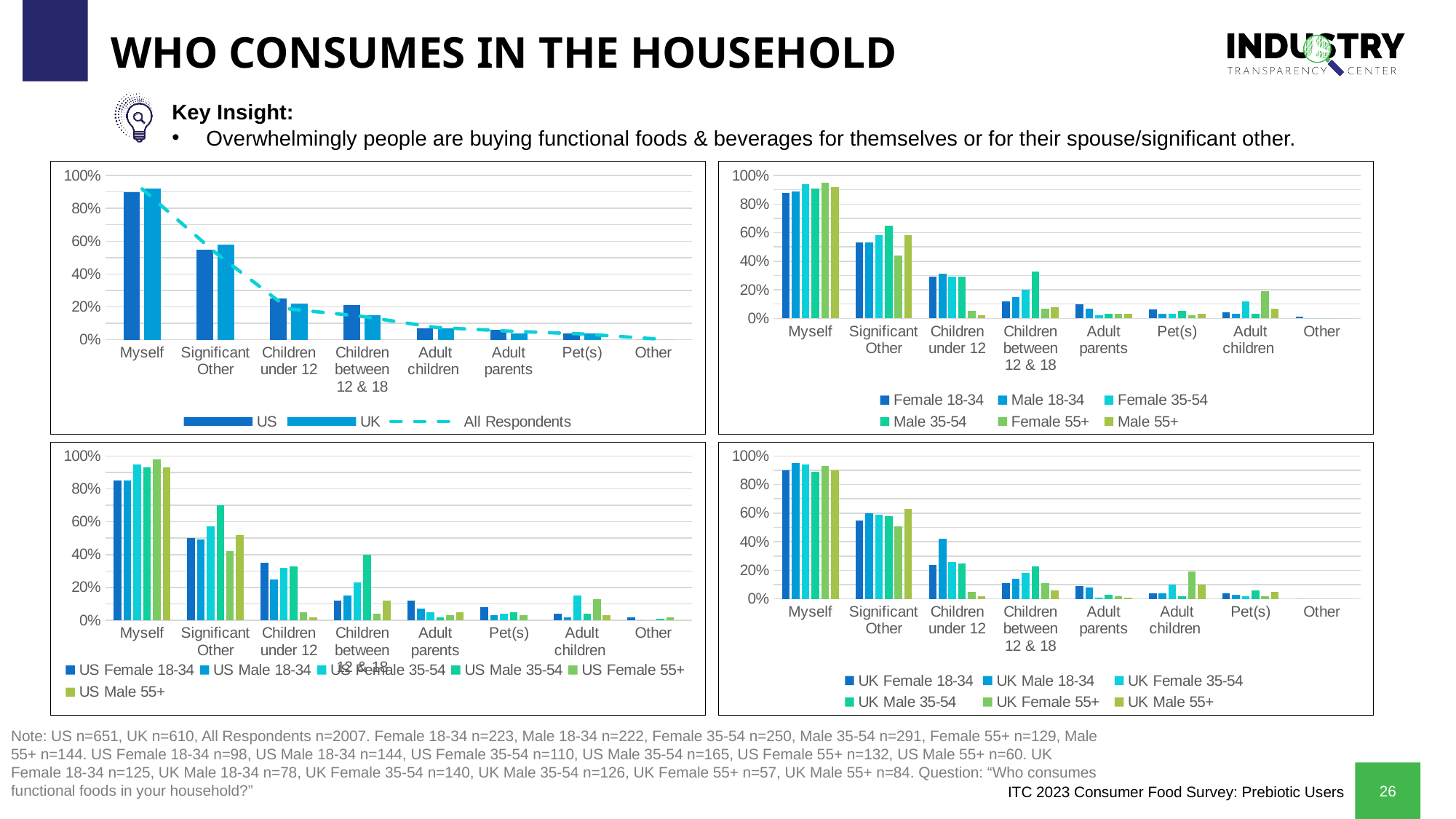
In the top-left chart, is the UK value for Children between 12 & 18 greater or less than 20%? less In the top-left chart, which category has the highest US value? Myself In the top-right chart, is the Male 35-54 value for Children between 12 & 18 greater or less than 20%? greater In the top-left chart, which category has the lowest UK value? Other How many household categories are shown on the x axis of the top-left chart? 8 In the bottom-right chart, is the UK Female 18-34 value for Myself greater or less than 80%? greater In the top-left chart, does the All Respondents line rise or fall from Myself to Other? fall How many series does the legend of the top-left chart list? 3 In the bottom-left chart, which series has the highest value for Significant Other? US Male 35-54 How many series does the legend of the top-right chart list? 6 What kind of chart is the top-left chart comparing US and UK? combination bar and line chart